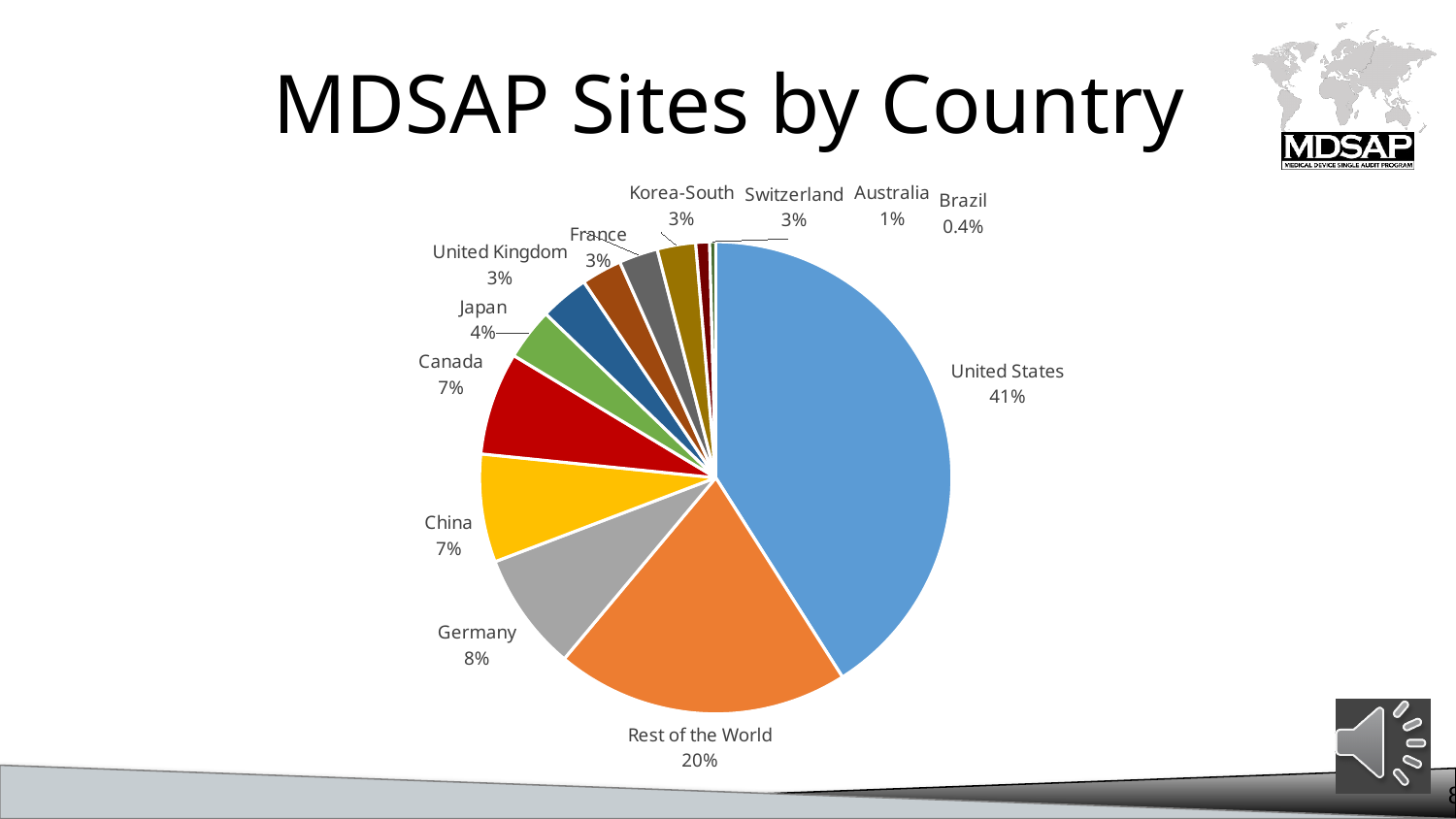
Which has a larger share of MDSAP sites, Germany or Japan? Germany Which country has the largest share of MDSAP sites? United States What is the value shown for Rest of the World? 20% Which category has the smallest slice in the pie chart? Brazil How many categories are shown in the pie chart? 12 What type of chart is shown on the slide? pie chart What is the title of the chart on the slide? MDSAP Sites by Country What percentage of MDSAP sites does Germany account for? 8% What percentage of MDSAP sites is in Canada? 7% What share of MDSAP sites is in the United States? 41% What is the difference in percentage points between the United States and Rest of the World? 21 What percentage is shown for Brazil? 0.4%